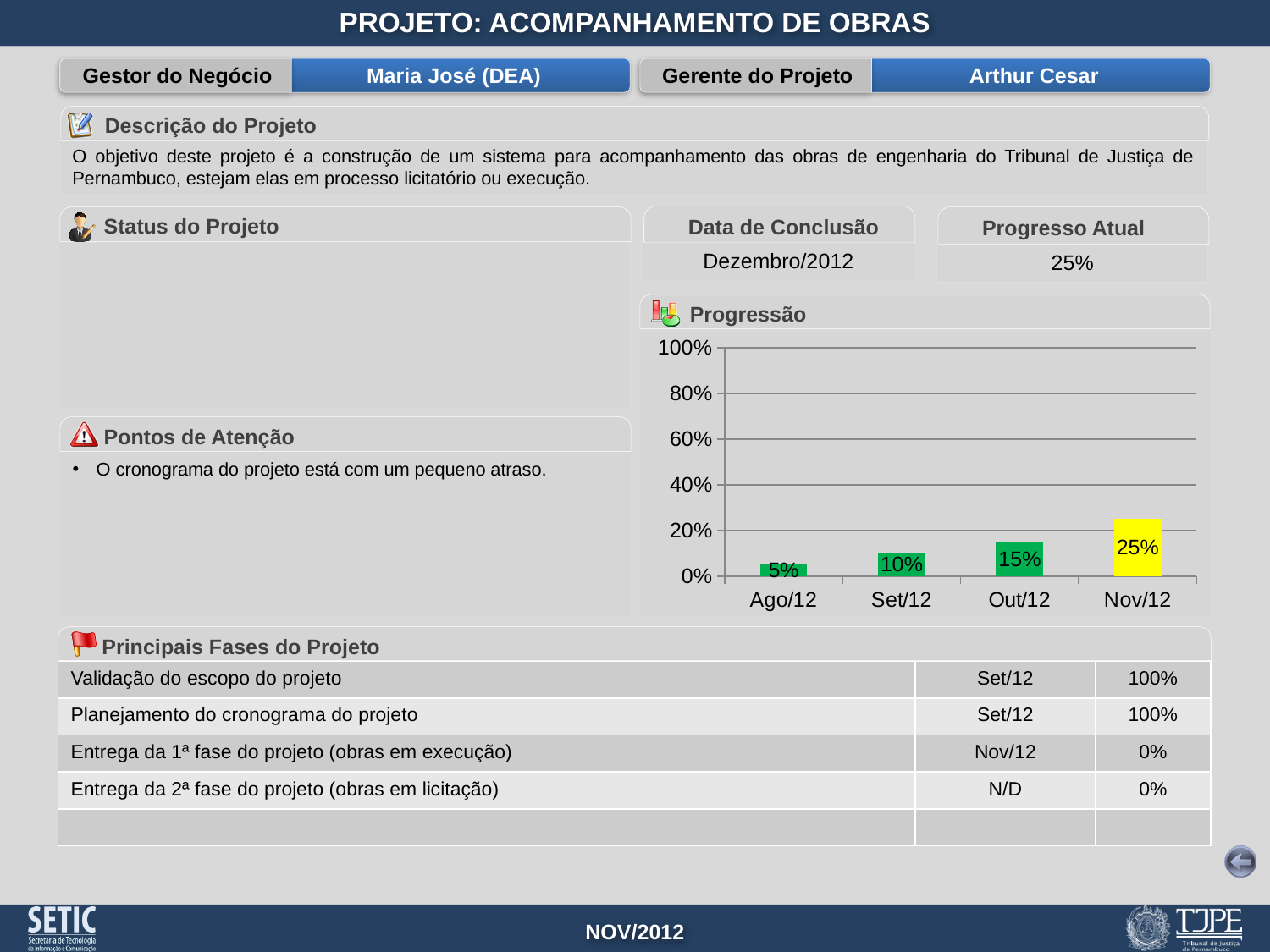
Is the value for Nov/12 in the Progressão chart greater or less than 20%? greater What is the difference between the values for Nov/12 and Out/12 in the Progressão chart? 10% What is the value for Out/12 in the Progressão chart? 15% Which month has the highest value in the Progressão chart? Nov/12 Do the values in the Progressão chart rise or fall from Ago/12 to Nov/12? rise What is the value for Ago/12 in the Progressão chart? 5% Which is larger in the Progressão chart, the value for Set/12 or the value for Out/12? Out/12 How many months are shown on the x axis of the Progressão chart? 4 What kind of chart is the Progressão chart? bar chart What is the value for Set/12 in the Progressão chart? 10% Which month has the lowest value in the Progressão chart? Ago/12 What is the value for Nov/12 in the Progressão chart? 25%